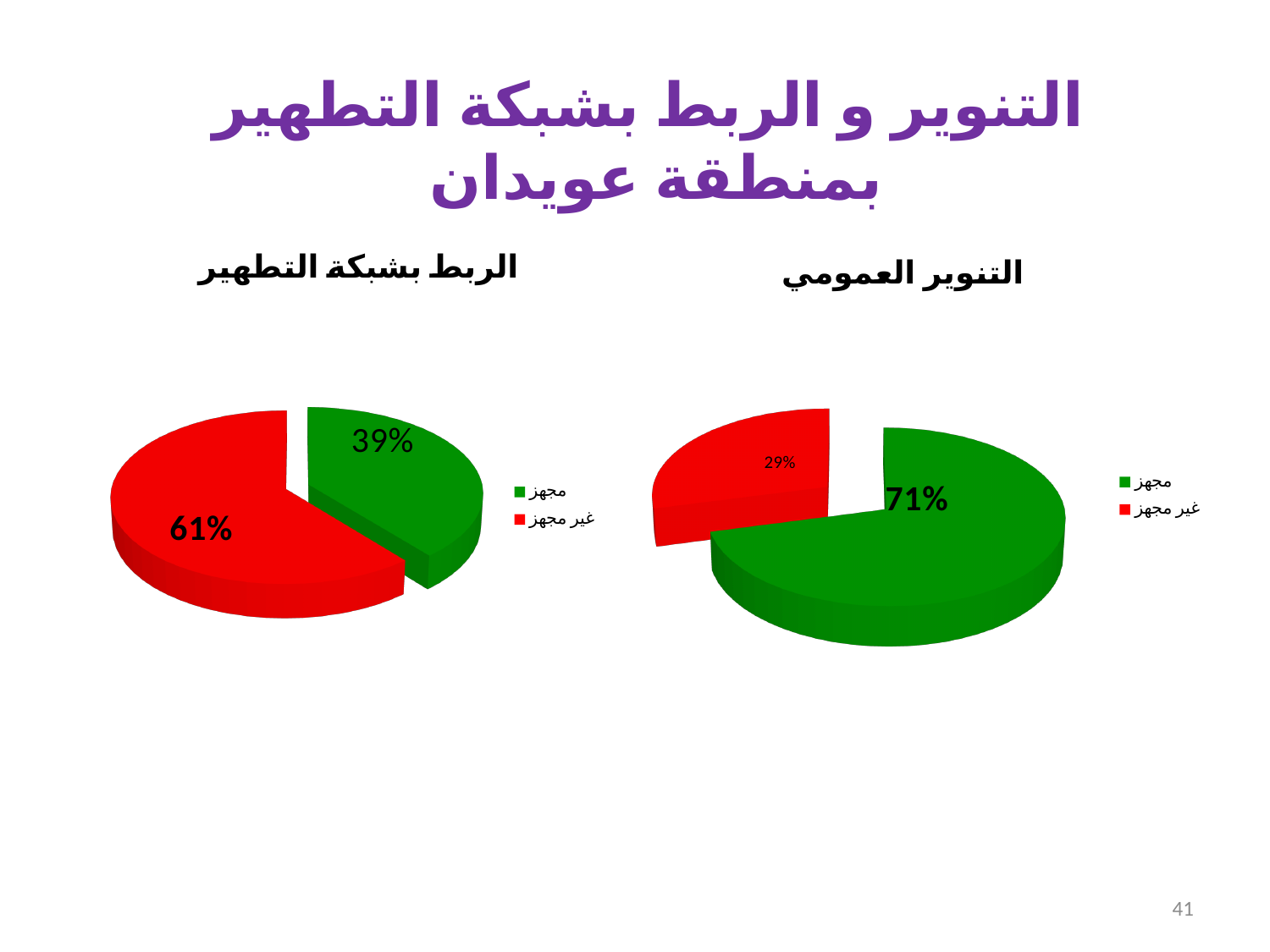
In the chart titled "التنوير العمومي" (right), what share is labelled for "غير مجهز"? 29% In the right chart ("التنوير العمومي"), what is the difference between the "مجهز" and "غير مجهز" shares? 42% In the right chart ("التنوير العمومي"), what colour represents "غير مجهز"? Red In the chart titled "التنوير العمومي" (right), what share is labelled for "مجهز"? 71% How many slices does the left chart ("الربط بشبكة التطهير") have? 2 In the chart titled "الربط بشبكة التطهير" (left), what share is labelled for "غير مجهز"? 61% What type of chart is used for "التنوير العمومي" on the right? Pie chart In the right chart ("التنوير العمومي"), which category has the smallest slice? غير مجهز In the left chart ("الربط بشبكة التطهير"), which category has the largest slice? غير مجهز In the left chart ("الربط بشبكة التطهير"), what is the difference between the "غير مجهز" and "مجهز" shares? 22% Is the "مجهز" share larger in the left chart ("الربط بشبكة التطهير") or the right chart ("التنوير العمومي")? التنوير العمومي In the chart titled "الربط بشبكة التطهير" (left), what share is labelled for "مجهز"? 39%